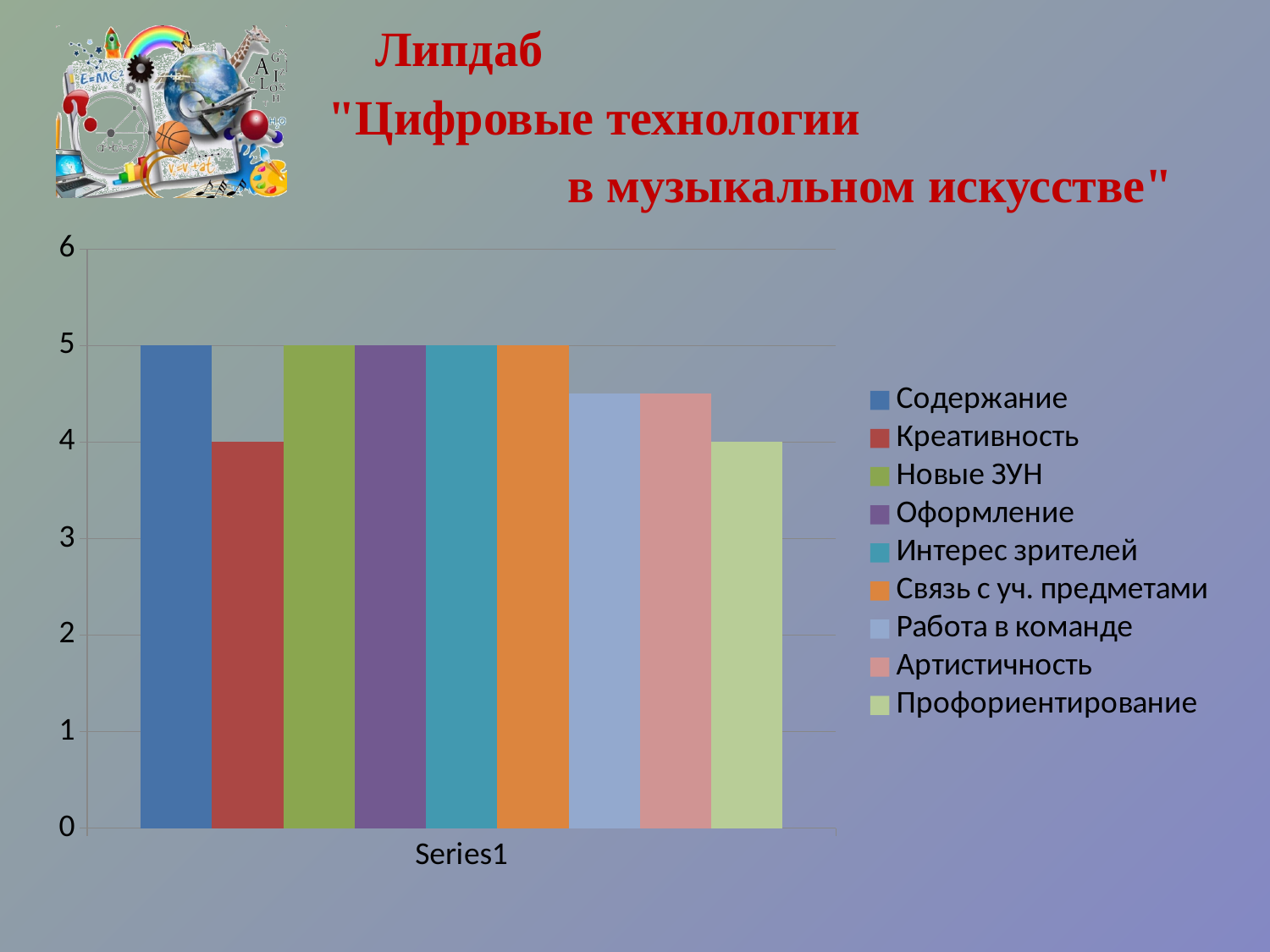
Is the value for Артистичность greater or less than 4? greater What kind of chart is shown on the slide? bar chart How many series does the legend list? 9 What is the value for Креативность? 4 Which is larger, the value for Оформление or the value for Креативность? Оформление What is the value for Профориентирование? 4 Is the value for Работа в команде greater or less than 5? less What is the value for Содержание? 5 What colour is the bar for Связь с уч. предметами? orange What is the value for Новые ЗУН? 5 What is the category label shown on the x axis? Series1 What is the difference between the values for Содержание and Креативность? 1